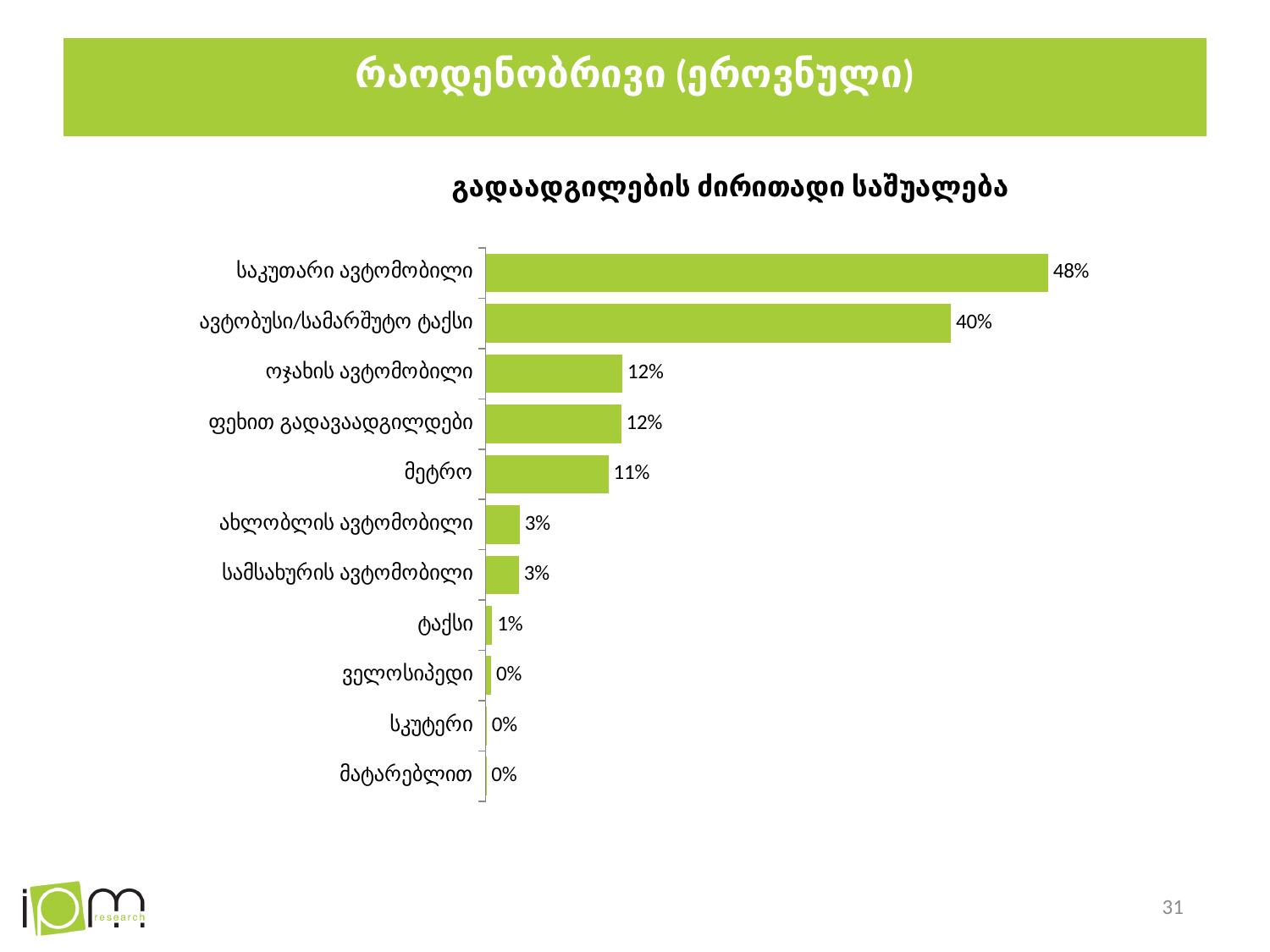
Which is larger, მეტრო or ახლობლის ავტომობილი? მეტრო What is the difference between ოჯახის ავტომობილი and მეტრო? 1% How many categories are shown in the chart? 11 What is the title of the chart? გადაადგილების ძირითადი საშუალება What value is shown for ტაქსი? 1% What value is shown for ავტობუსი/სამარშუტო ტაქსი? 40% What is the difference between საკუთარი ავტომობილი and ავტობუსი/სამარშუტო ტაქსი? 8% What value is shown for მეტრო? 11% What value is shown for საკუთარი ავტომობილი? 48% What kind of chart is shown on the slide? Bar chart Which category has the highest value? საკუთარი ავტომობილი How many categories show a value of 0%? 3